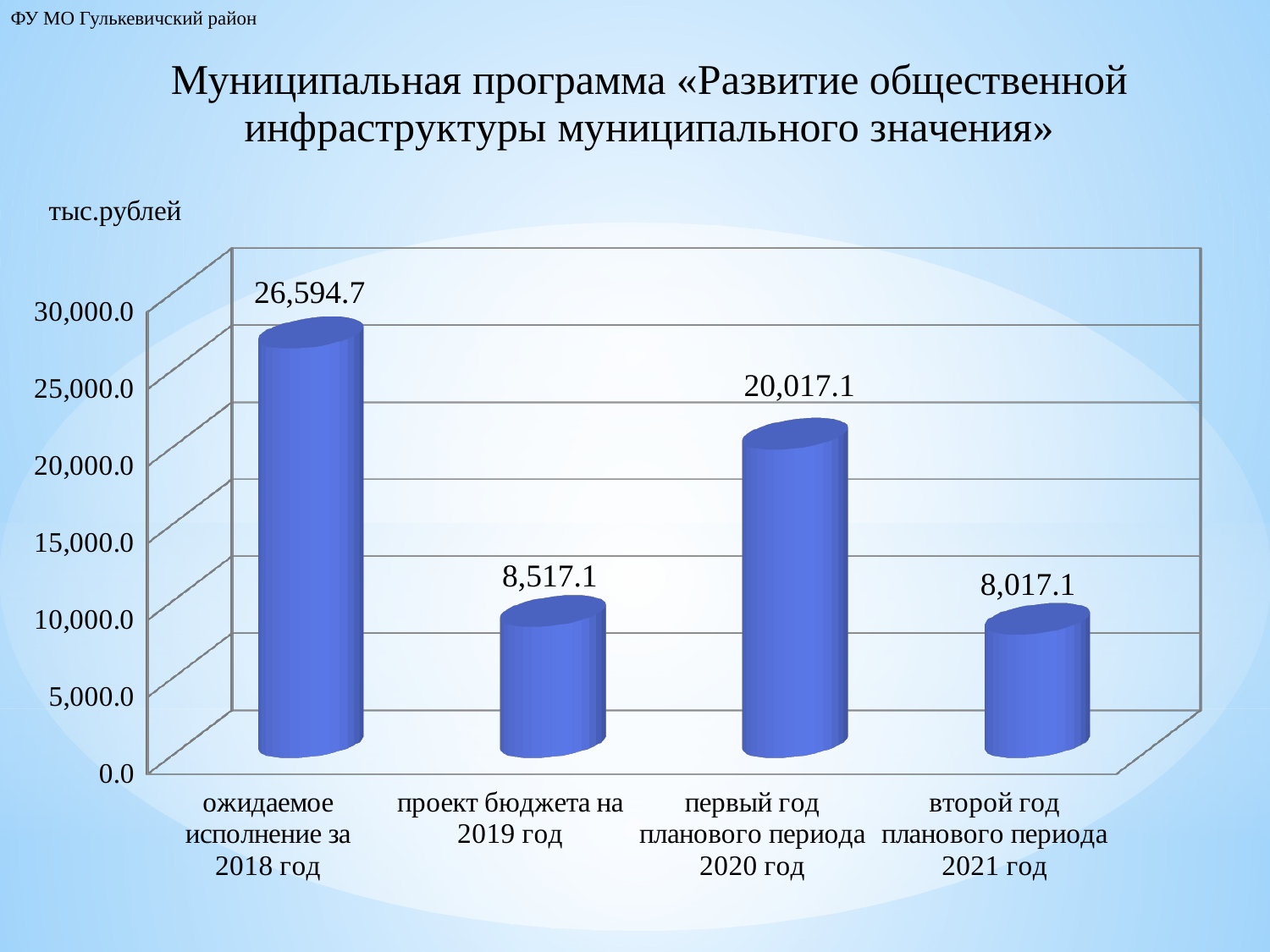
What is the difference between the values for 2020 and 2021 of the planning period? 12,000.0 What is the value for 'второй год планового периода 2021 год'? 8,017.1 What is the difference between the values for 2018 (ожидаемое исполнение) and 2019 (проект бюджета)? 18,077.6 What is the value for 'ожидаемое исполнение за 2018 год'? 26,594.7 What is the value for 'первый год планового периода 2020 год'? 20,017.1 How many categories are shown on the chart? 4 Which category has the lowest value? второй год планового периода 2021 год Which category has the highest value? ожидаемое исполнение за 2018 год What is the value for 'проект бюджета на 2019 год'? 8,517.1 Which is larger: the value for 2019 (проект бюджета) or the value for 2020 (первый год планового периода)? первый год планового периода 2020 год What kind of chart is shown on the slide? bar chart What unit of measurement is indicated above the chart? тыс.рублей